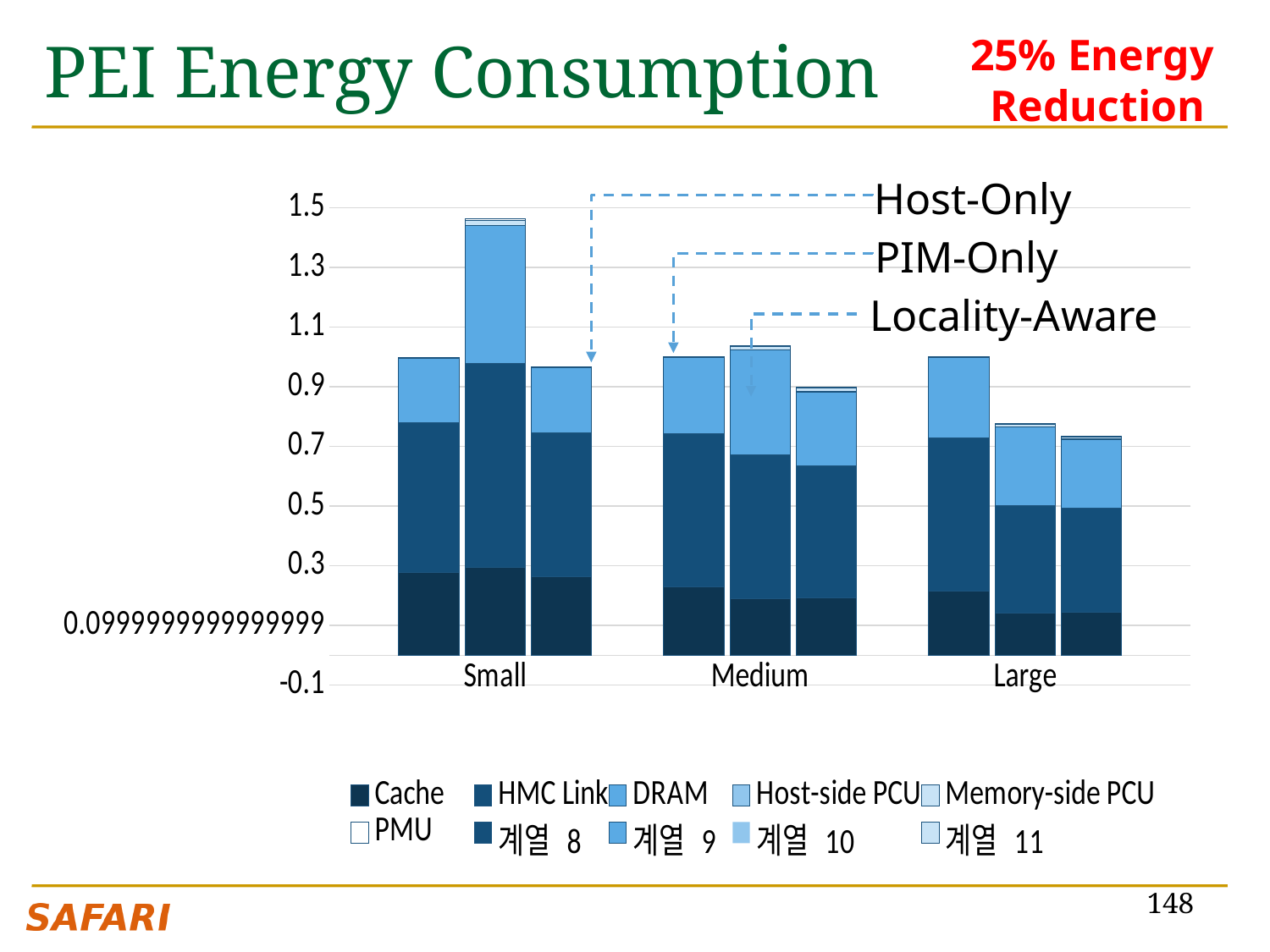
Is the PIM-Only bar for Large greater or less than 0.9? less For Medium, which bar is taller: PIM-Only or Locality-Aware? PIM-Only Is the Locality-Aware bar for Large greater or less than 0.9? less What kind of chart is shown on the slide? stacked bar chart What is the title of the chart? PEI Energy Consumption What energy reduction is highlighted in red at the top right of the slide? 25% Energy Reduction Do the Locality-Aware bars rise or fall from Small to Large? fall Is the PIM-Only bar for Small greater or less than 1.3? greater How many workload size categories are shown on the x axis? 3 For Small, which bar is taller: PIM-Only or Locality-Aware? PIM-Only How many entries does the legend list? 10 Which bar is the tallest in the chart? PIM-Only for Small